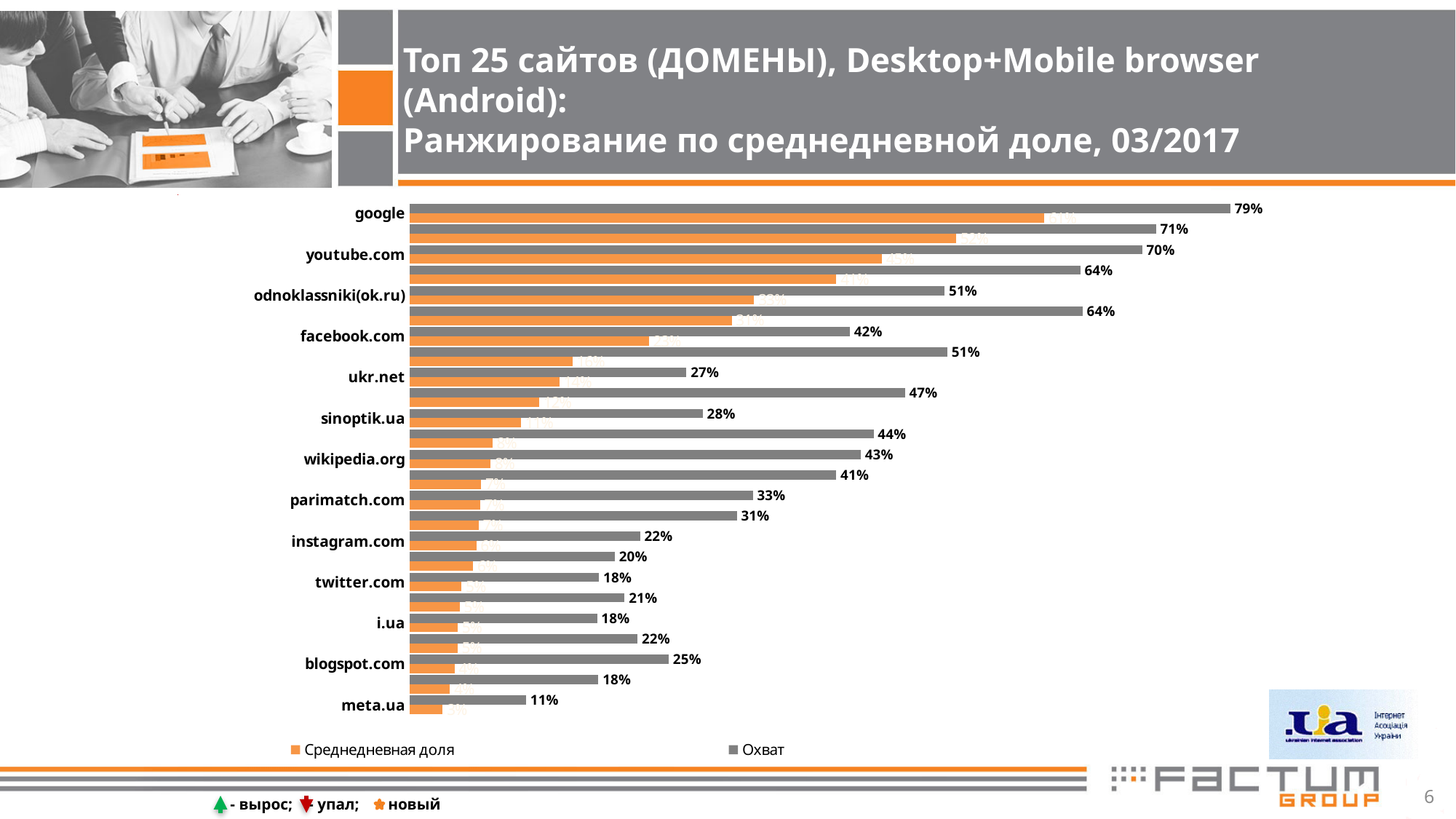
What is the Охват value for meta.ua? 11% Which site has the highest Охват value? google What is the Охват value for google? 79% How many series does the legend list? 2 Which has a larger Охват value, wikipedia.org or parimatch.com? wikipedia.org What is the Охват value for facebook.com? 42% Which series is shown in orange according to the legend? Среднедневная доля Which site has the lowest Охват value? meta.ua What is the Охват value for youtube.com? 70% What is the difference between the Охват values for google and youtube.com? 9 percentage points What kind of chart is shown on the slide? Bar chart What is the Охват value for parimatch.com? 33%